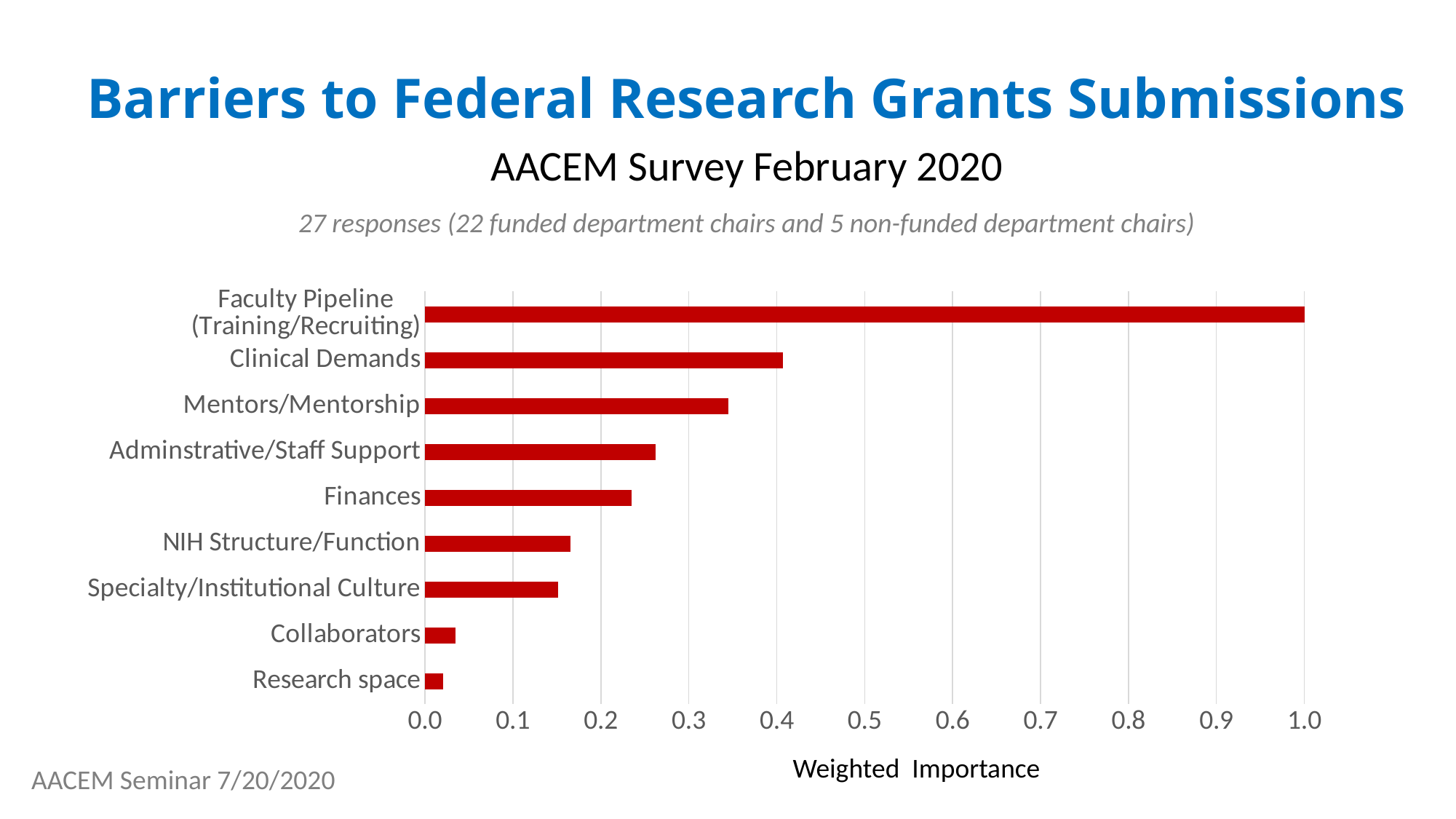
What is the weighted importance value for Faculty Pipeline (Training/Recruiting)? 1.0 Is the weighted importance for Collaborators greater or less than 0.1? less Which barrier has the lowest weighted importance? Research space Is the weighted importance for Adminstrative/Staff Support greater or less than 0.3? less How many barrier categories are plotted in the chart? 9 What is the label of the horizontal axis of the chart? Weighted Importance Which barrier has the highest weighted importance? Faculty Pipeline (Training/Recruiting) What kind of chart is shown on the slide? bar chart Is the weighted importance for Clinical Demands greater or less than 0.5? less Which has a higher weighted importance, Clinical Demands or Finances? Clinical Demands